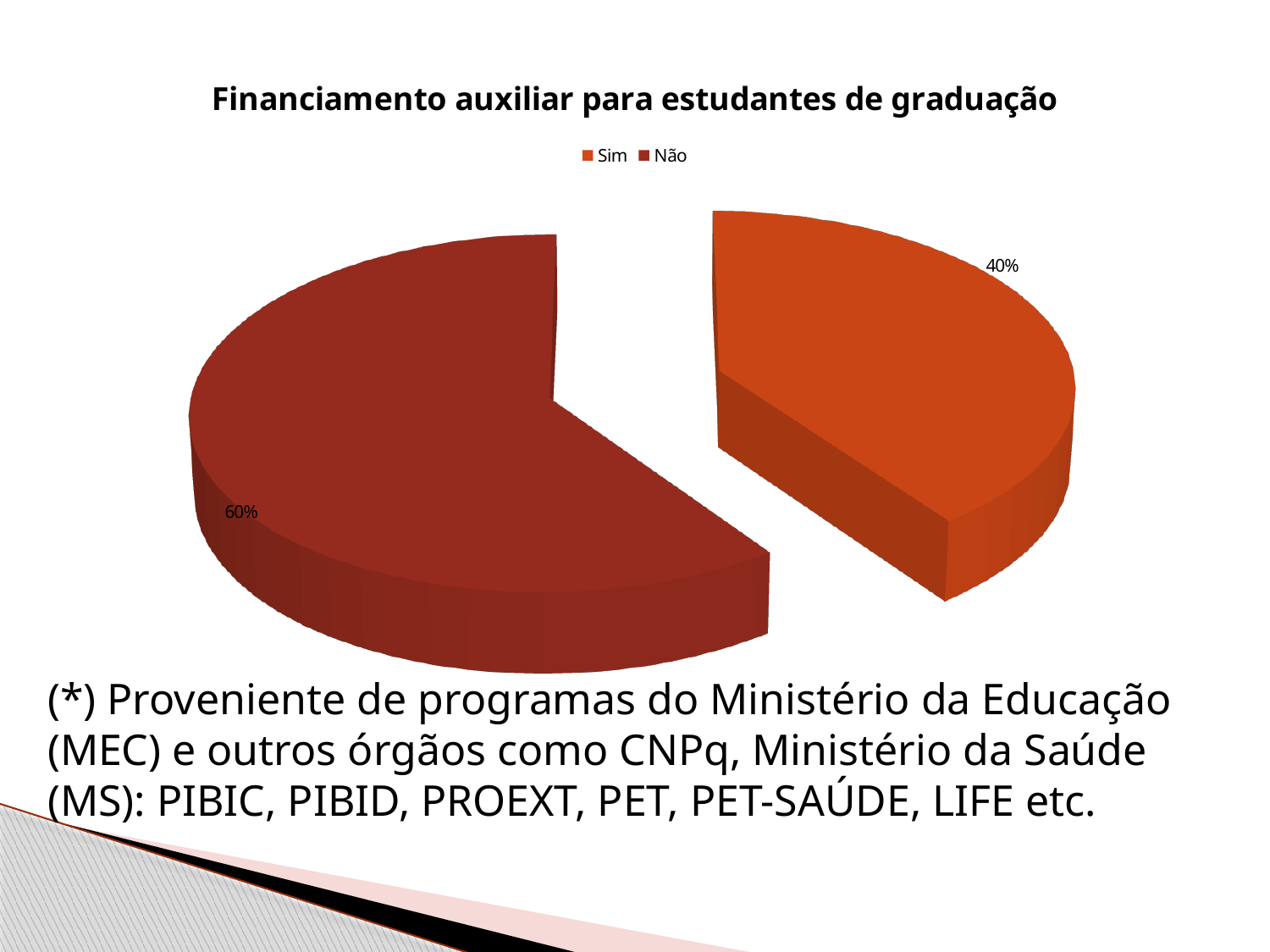
Which legend entry is shown in the darker red colour? Não How many slices does the pie chart have? 2 What kind of chart is shown on the slide? pie chart What is the difference in percentage points between the 'Não' slice and the 'Sim' slice? 20% Which slice is the largest? Não Which slice is the smallest? Sim What share of the pie does the 'Sim' slice represent? 40% What share of the pie does the 'Não' slice represent? 60% What is the title of the chart? Financiamento auxiliar para estudantes de graduação How many entries does the legend list? 2 Which is larger, the 'Sim' slice or the 'Não' slice? Não